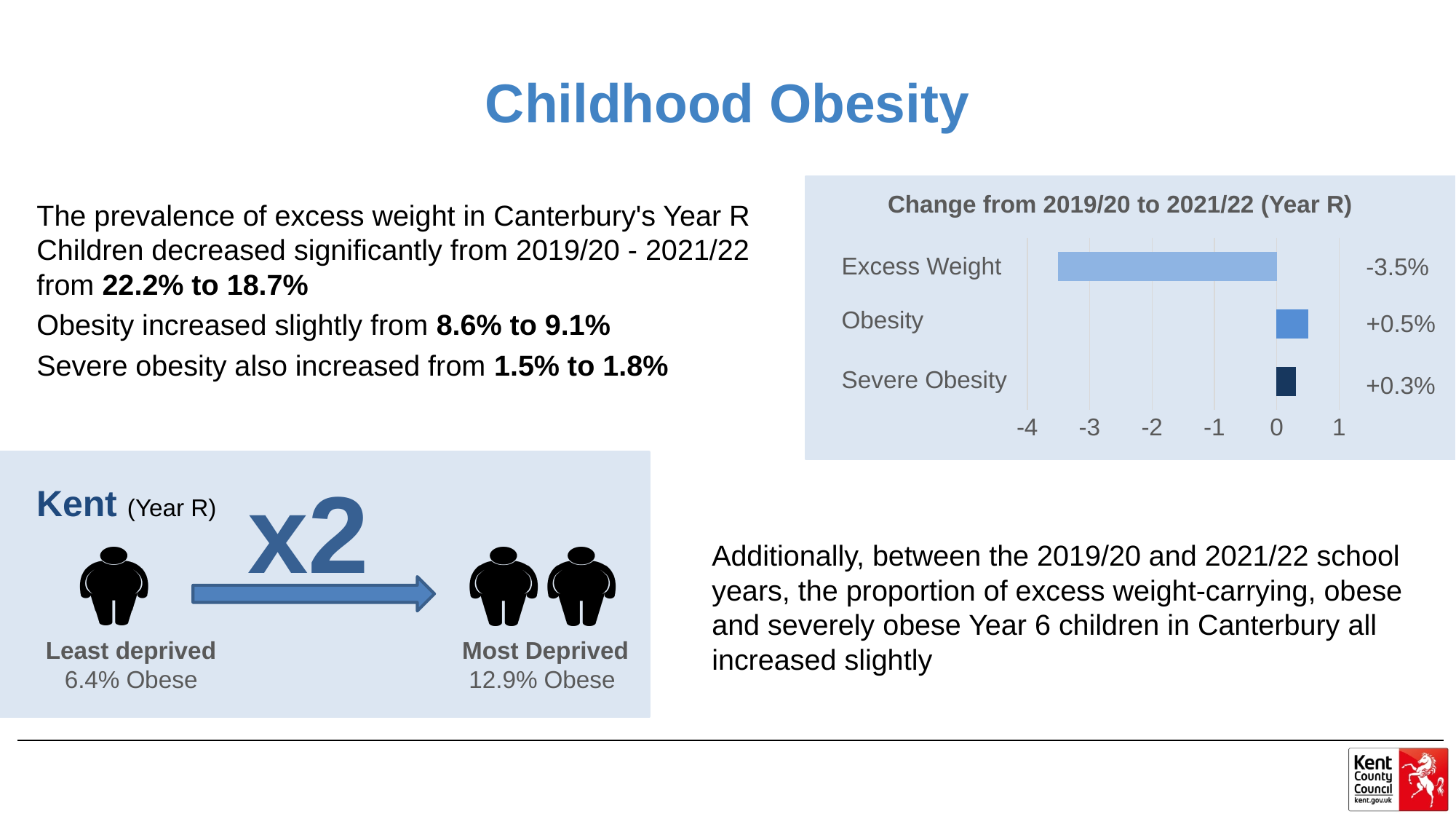
What is the difference between the values for Obesity and Severe Obesity in the chart? 0.2% Which is larger in the chart, the value for Obesity or the value for Severe Obesity? Obesity Which category in the chart has the highest value? Obesity Which category in the chart has the lowest value? Excess Weight What is the value shown for Severe Obesity in the chart? +0.3% What is the title of the chart on the slide? Change from 2019/20 to 2021/22 (Year R) Is the value for Excess Weight in the chart greater or less than -3? less What kind of chart is shown on the slide? bar chart What is the value shown for Excess Weight in the chart? -3.5% What is the value shown for Obesity in the chart? +0.5% Which category in the chart is the only one with a negative change? Excess Weight How many categories does the chart show? 3